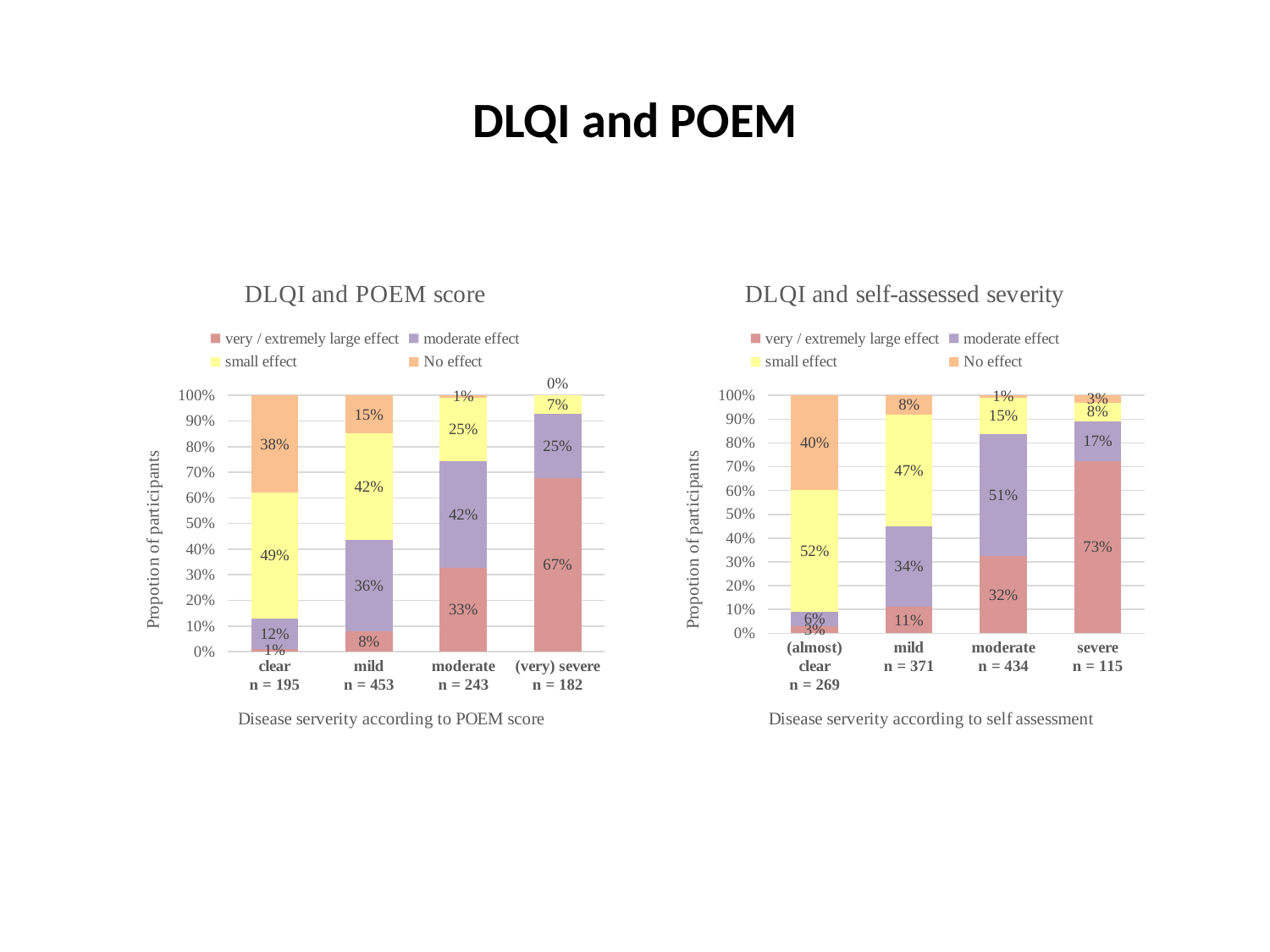
In the 'DLQI and self-assessed severity' chart, what percentage of the mild group (n = 371) reported a small effect? 47% How many series does the legend of the 'DLQI and self-assessed severity' chart list? 4 In the 'DLQI and POEM score' chart, what percentage of participants in the moderate group (n = 243) reported a very / extremely large effect? 33% In the 'DLQI and POEM score' chart, what is the difference between the small effect share in the clear group (49%) and in the mild group (42%)? 7% How many severity categories are shown on the x axis of the 'DLQI and POEM score' chart? 4 In the 'DLQI and POEM score' chart, which severity group has the highest share of participants reporting a very / extremely large effect? (very) severe What type of chart is the 'DLQI and POEM score' chart? stacked bar chart In the 'DLQI and POEM score' chart, what percentage of the clear group (n = 195) reported no effect? 38% In the 'DLQI and self-assessed severity' chart, what percentage of the severe group (n = 115) reported a very / extremely large effect? 73% In the 'DLQI and self-assessed severity' chart, does the share of participants reporting a very / extremely large effect rise or fall from (almost) clear to severe? rise In the 'DLQI and self-assessed severity' chart, which is larger: the moderate effect share in the moderate group or in the mild group? moderate group In the 'DLQI and self-assessed severity' chart, which severity group has the lowest share of participants reporting no effect? moderate